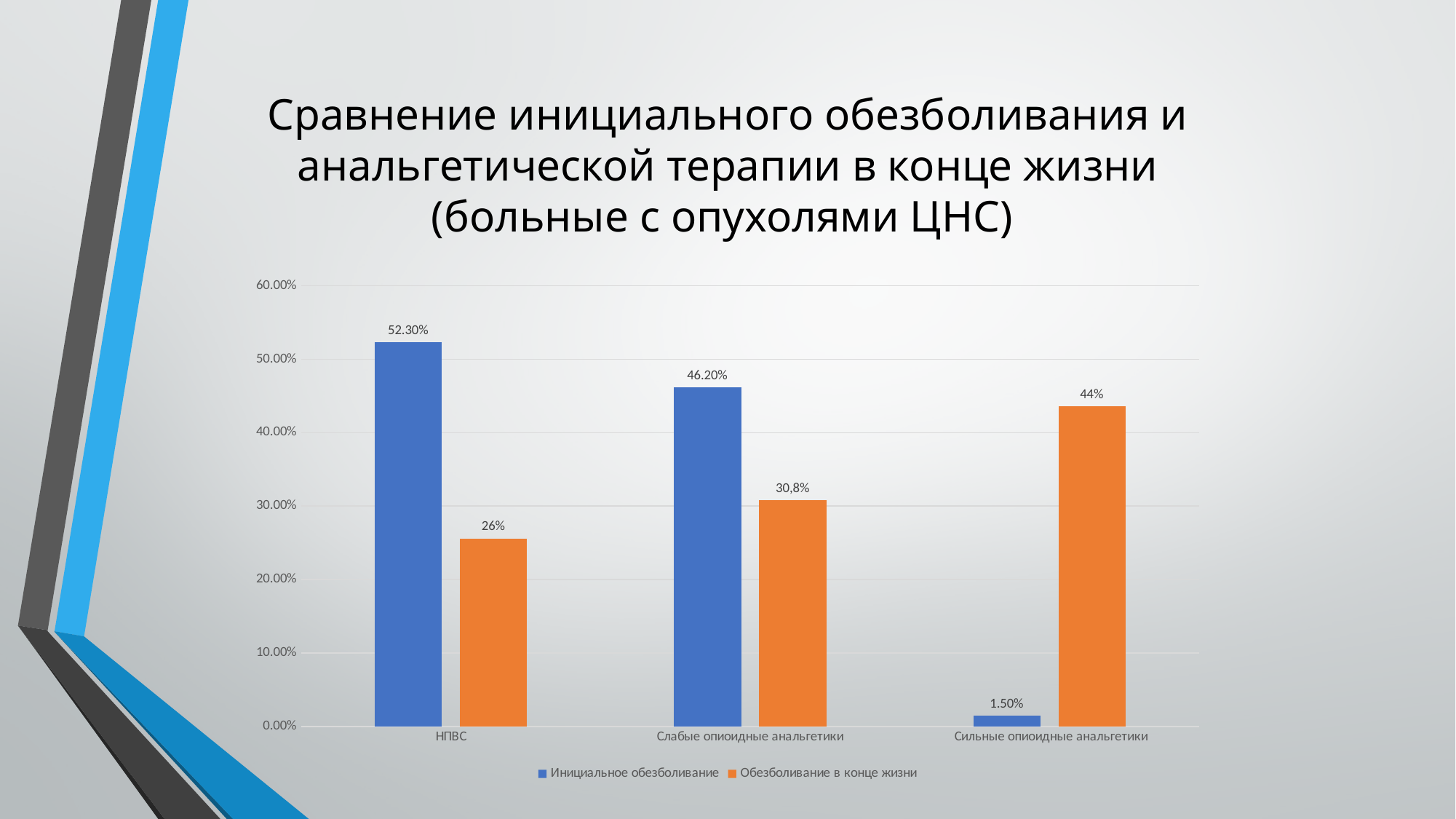
In the Сильные опиоидные анальгетики category, which series has the larger value? Обезболивание в конце жизни Which colour represents the Обезболивание в конце жизни series? orange What is the value for Инициальное обезболивание in the Сильные опиоидные анальгетики category? 1.50% What is the value for Обезболивание в конце жизни in the Слабые опиоидные анальгетики category? 30,8% What is the value for Обезболивание в конце жизни in the Сильные опиоидные анальгетики category? 44% What type of chart is shown on the slide? bar chart Which category has the highest value for Инициальное обезболивание? НПВС Which category has the lowest value for Обезболивание в конце жизни? НПВС How many categories are shown on the x axis? 3 What is the difference between Инициальное обезболивание and Обезболивание в конце жизни in the НПВС category? 26.3 percentage points How many series does the legend list? 2 What is the value for Инициальное обезболивание in the НПВС category? 52.30%